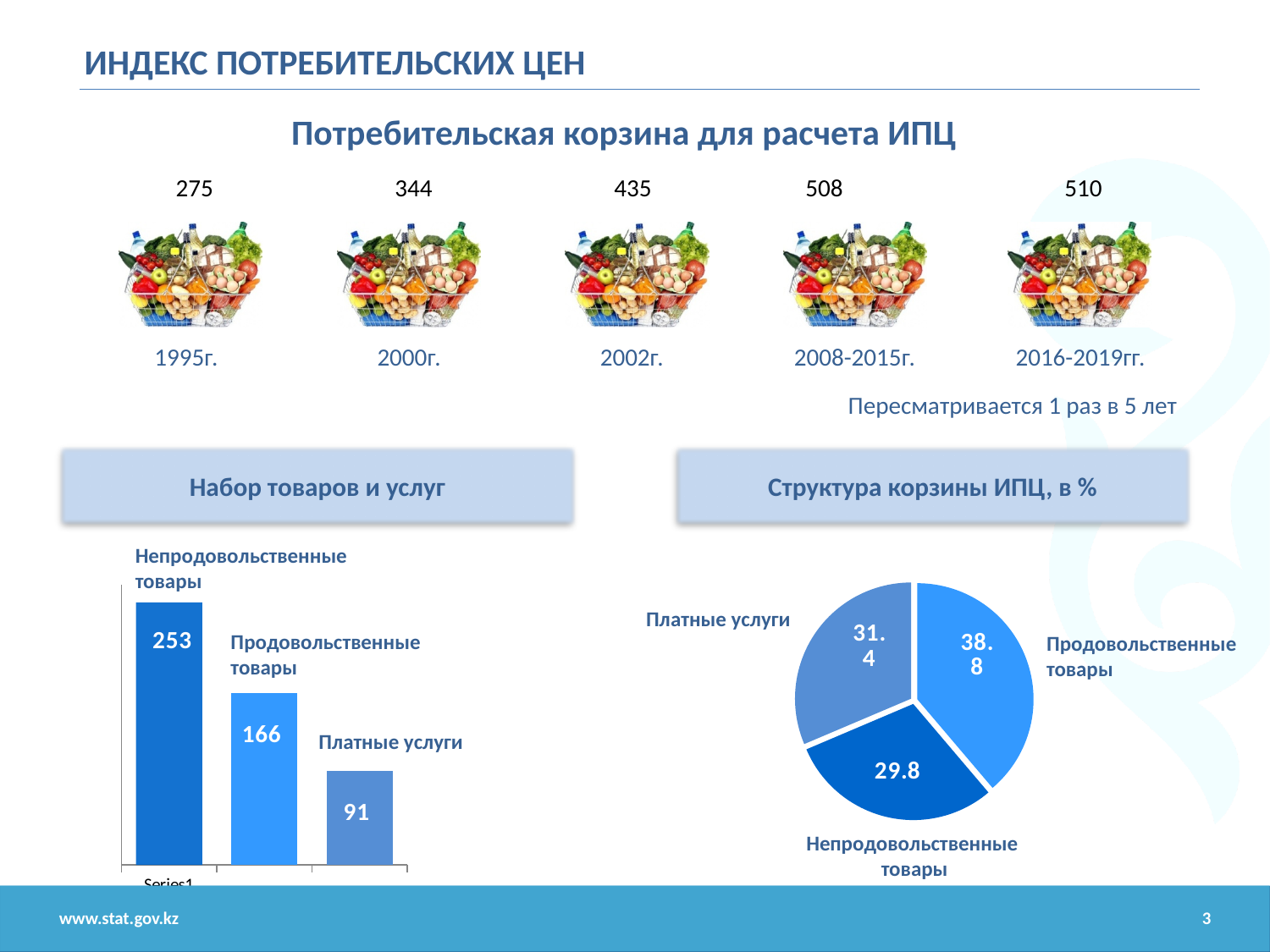
In the bar chart 'Набор товаров и услуг', what is the value for Платные услуги? 91 In the bar chart 'Набор товаров и услуг', what is the difference between Непродовольственные товары and Продовольственные товары? 87 What type of chart is 'Структура корзины ИПЦ, в %'? pie chart In the bar chart 'Набор товаров и услуг', what is the value for Непродовольственные товары? 253 In the pie chart 'Структура корзины ИПЦ, в %', which category has the largest share? Продовольственные товары In the bar chart 'Набор товаров и услуг', which category has the highest value? Непродовольственные товары In the bar chart 'Набор товаров и услуг', which category has the lowest value? Платные услуги In the pie chart 'Структура корзины ИПЦ, в %', what is the value for Непродовольственные товары? 29.8 What type of chart is 'Набор товаров и услуг'? bar chart In the pie chart 'Структура корзины ИПЦ, в %', which is larger: Платные услуги or Непродовольственные товары? Платные услуги In the pie chart 'Структура корзины ИПЦ, в %', what is the value for Продовольственные товары? 38.8 In the bar chart 'Набор товаров и услуг', how many bars are shown? 3